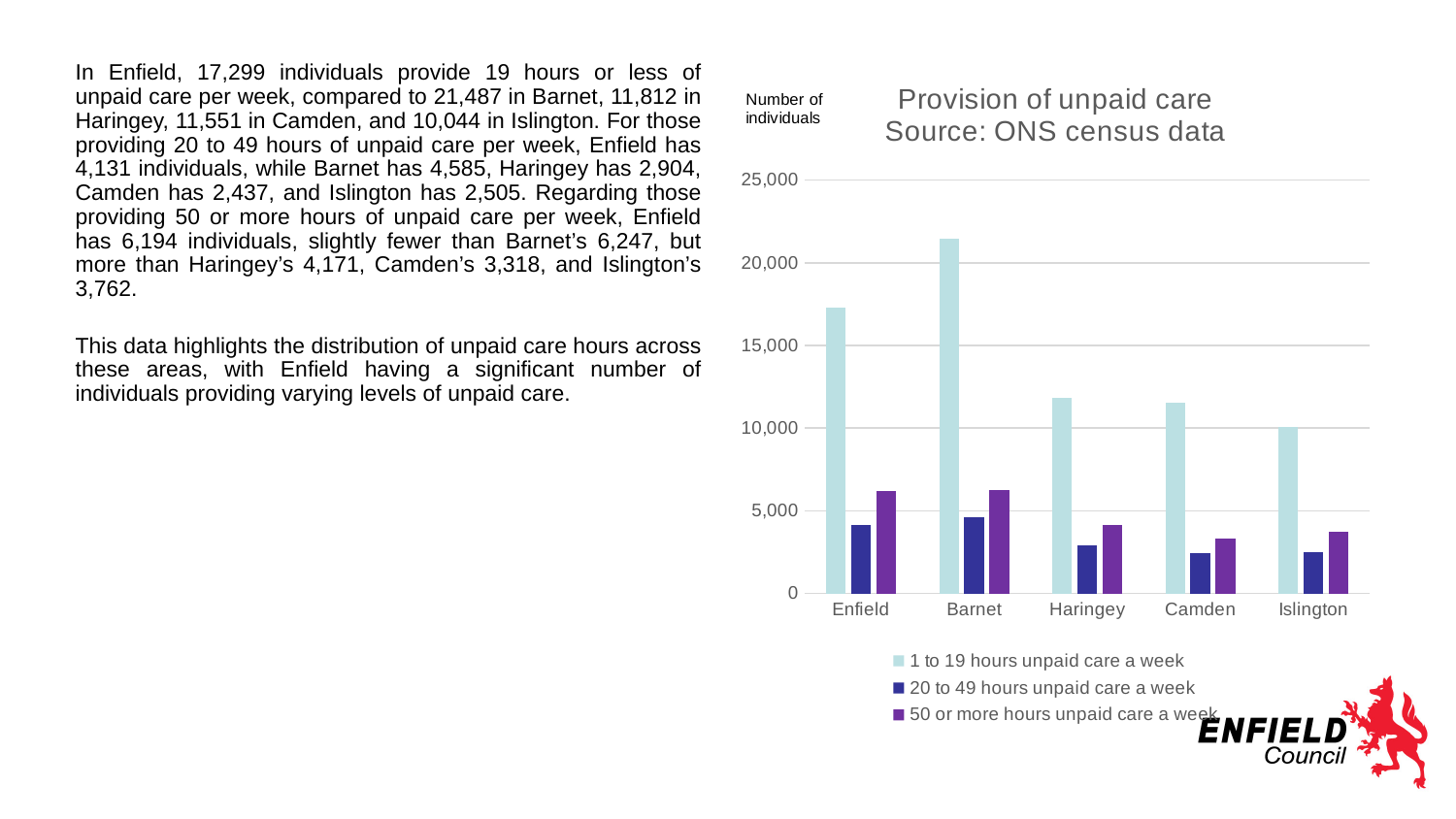
How many boroughs are shown on the x axis of the chart? 5 Is the value for Enfield in the 1 to 19 hours unpaid care a week series greater or less than 15,000? greater What kind of chart is shown on the slide? bar chart Using the figures given on the slide, how many more individuals provide 1 to 19 hours of unpaid care a week in Barnet than in Enfield? 4,188 What is the title of the chart? Provision of unpaid care Source: ONS census data Which is larger: the 1 to 19 hours unpaid care a week value for Enfield or for Haringey? Enfield Is the value for Camden in the 50 or more hours unpaid care a week series greater or less than 5,000? less According to the slide, how many individuals in Enfield provide 1 to 19 hours of unpaid care a week? 17,299 How many series does the legend of the chart list? 3 Is the value for Barnet in the 1 to 19 hours unpaid care a week series greater or less than 20,000? greater Which borough has the lowest bar for 1 to 19 hours unpaid care a week? Islington Which borough has the highest bar for 1 to 19 hours unpaid care a week? Barnet